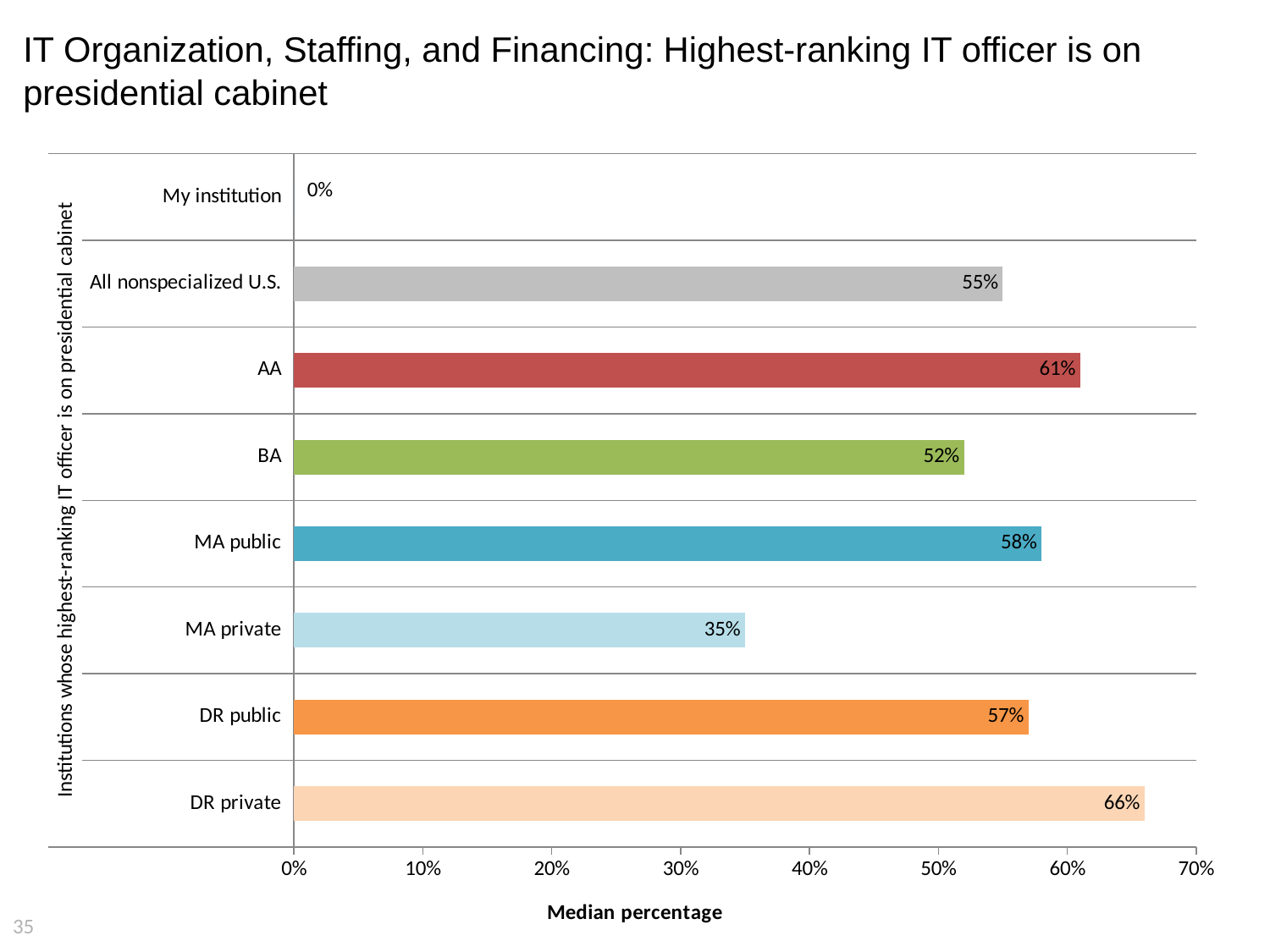
What kind of chart is shown on the slide? bar chart What is the difference between the values for AA and BA? 9% How many categories are shown on the chart? 8 What is the value for All nonspecialized U.S.? 55% Which is larger, the value for MA public or the value for DR public? MA public What is the value for MA private? 35% Is the value for MA private greater or less than 40%? less What is the label of the horizontal axis? Median percentage Which category has the lowest value? My institution What is the difference between the values for DR private and DR public? 9% What is the value for DR private? 66% Which category has the highest value? DR private